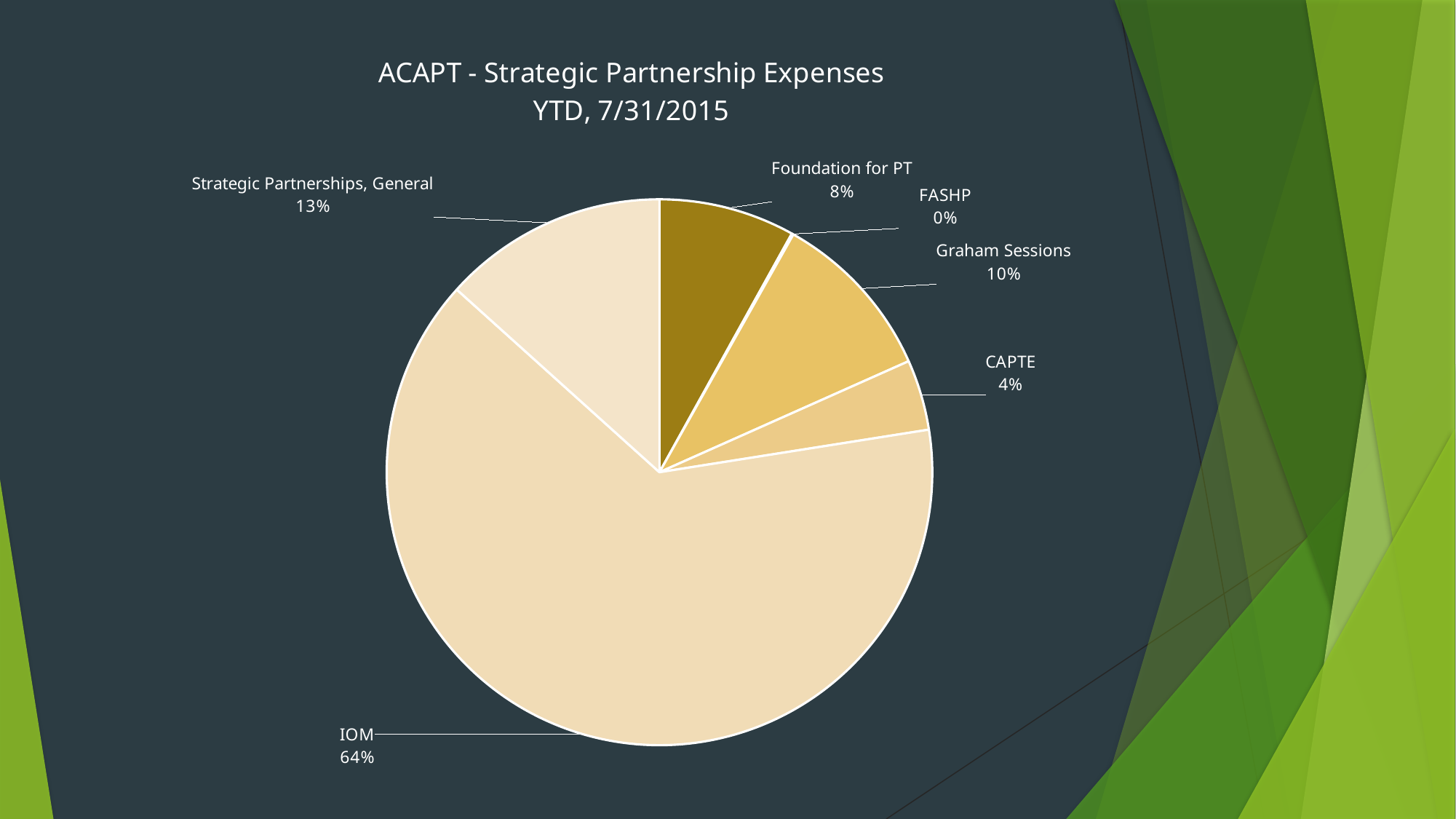
What type of chart is shown on the slide? Pie chart Which category has the smallest slice of the pie? FASHP What percentage is shown for Foundation for PT? 8% What share of the pie does IOM account for? 64% Which is larger, Graham Sessions or Foundation for PT? Graham Sessions What percentage is shown for CAPTE? 4% What percentage is shown for FASHP? 0% What is the difference in percentage points between IOM and Strategic Partnerships, General? 51 What percentage is shown for Graham Sessions? 10% What percentage is shown for Strategic Partnerships, General? 13% Which category has the largest slice of the pie? IOM How many categories are shown in the pie chart? 6